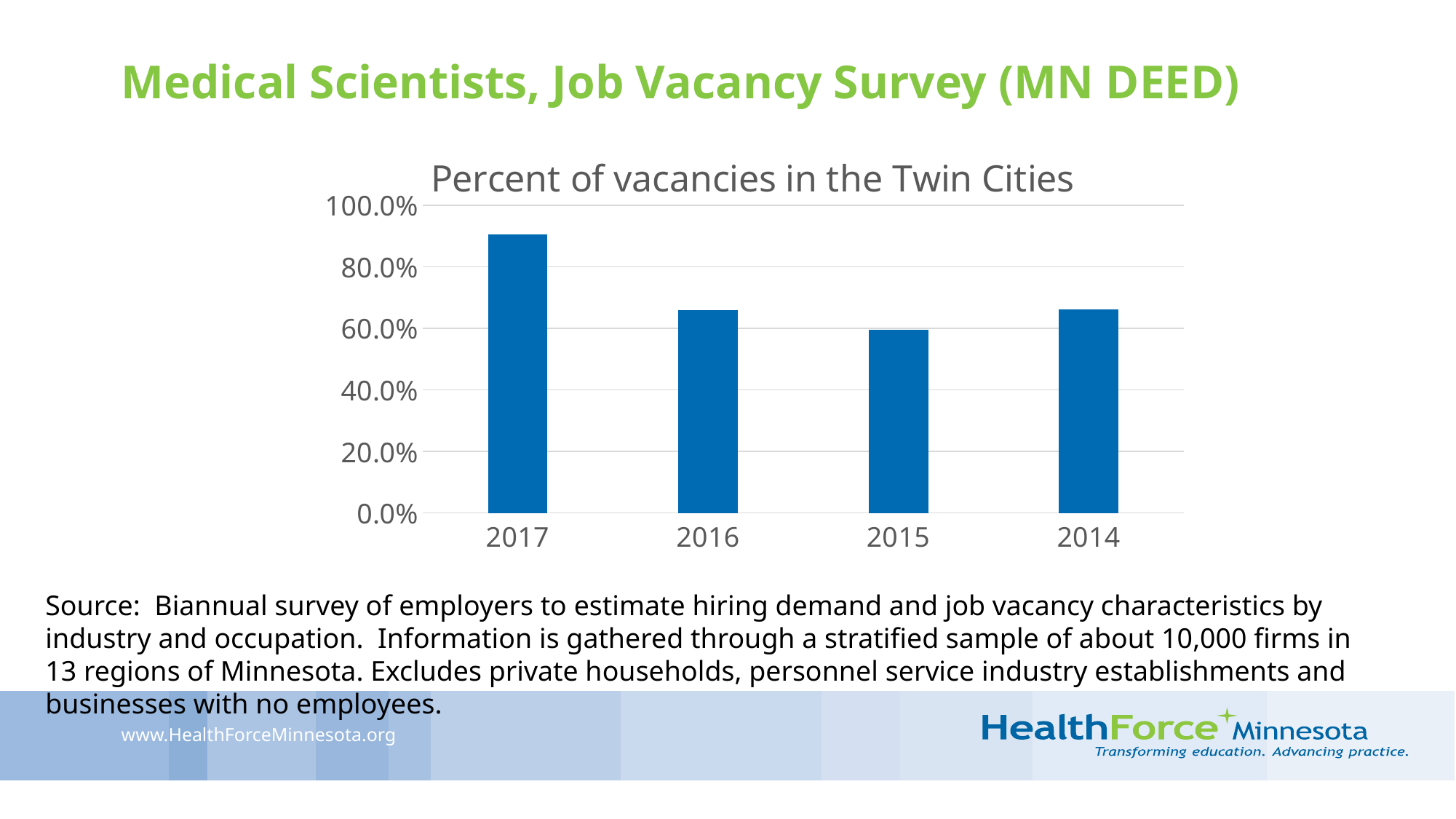
What kind of chart is shown on the slide? bar chart Is the value for 2014 greater or less than 80.0%? less Is the value for 2015 greater or less than 40.0%? greater Which year has the lowest percent of vacancies in the Twin Cities? 2015 Which year has the highest percent of vacancies in the Twin Cities? 2017 Is the value for 2017 greater or less than 80.0%? greater What is the highest value shown on the y axis of the chart? 100.0% How many years are shown on the x axis of the chart? 4 What is the title of the chart? Percent of vacancies in the Twin Cities Which is larger, the value for 2017 or the value for 2016? 2017